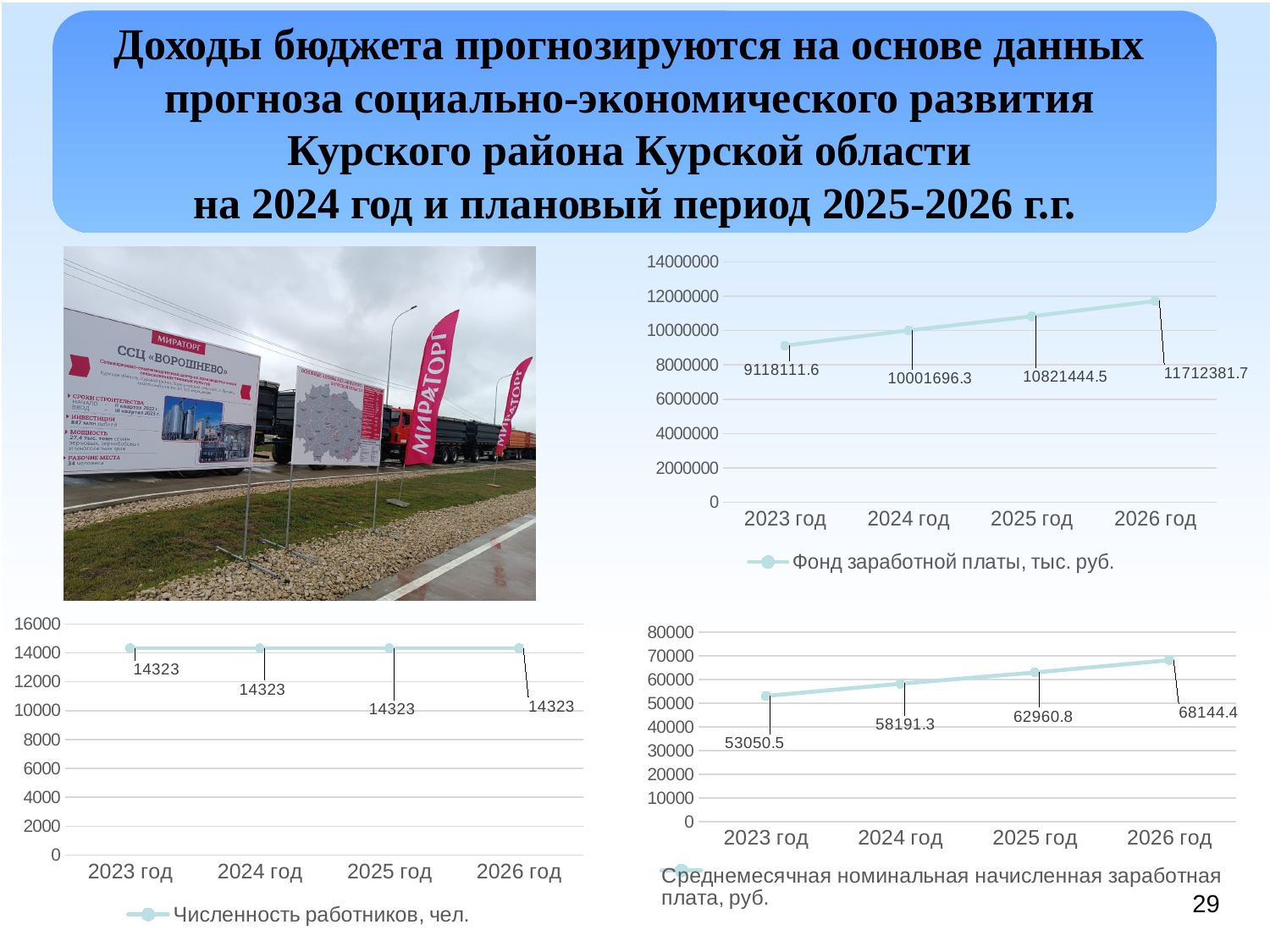
In the bottom-right chart (Среднемесячная номинальная начисленная заработная плата, руб.), what is the difference between the values for 2026 год and 2023 год? 15093.9 In the top-right chart (Фонд заработной платы, тыс. руб.), do the values rise or fall from 2023 год to 2026 год? rise In the top-right chart (Фонд заработной платы, тыс. руб.), what is the difference between the values for 2025 год and 2024 год? 819748.2 In the bottom-right chart (Среднемесячная номинальная начисленная заработная плата, руб.), which year has the lowest value? 2023 год In the bottom-left chart (Численность работников, чел.), what is the value for 2024 год? 14323 In the top-right chart (Фонд заработной платы, тыс. руб.), what is the value for 2026 год? 11712381.7 What type of chart is the bottom-right chart (Среднемесячная номинальная начисленная заработная плата, руб.)? line chart In the bottom-right chart (Среднемесячная номинальная начисленная заработная плата, руб.), what is the value for 2025 год? 62960.8 In the top-right chart (Фонд заработной платы, тыс. руб.), what is the value for 2023 год? 9118111.6 In the bottom-left chart (Численность работников, чел.), do the values rise, fall or stay the same across the years? stay the same In the top-right chart (Фонд заработной платы, тыс. руб.), which year has the highest value? 2026 год How many data points are plotted in the bottom-left chart (Численность работников, чел.)? 4